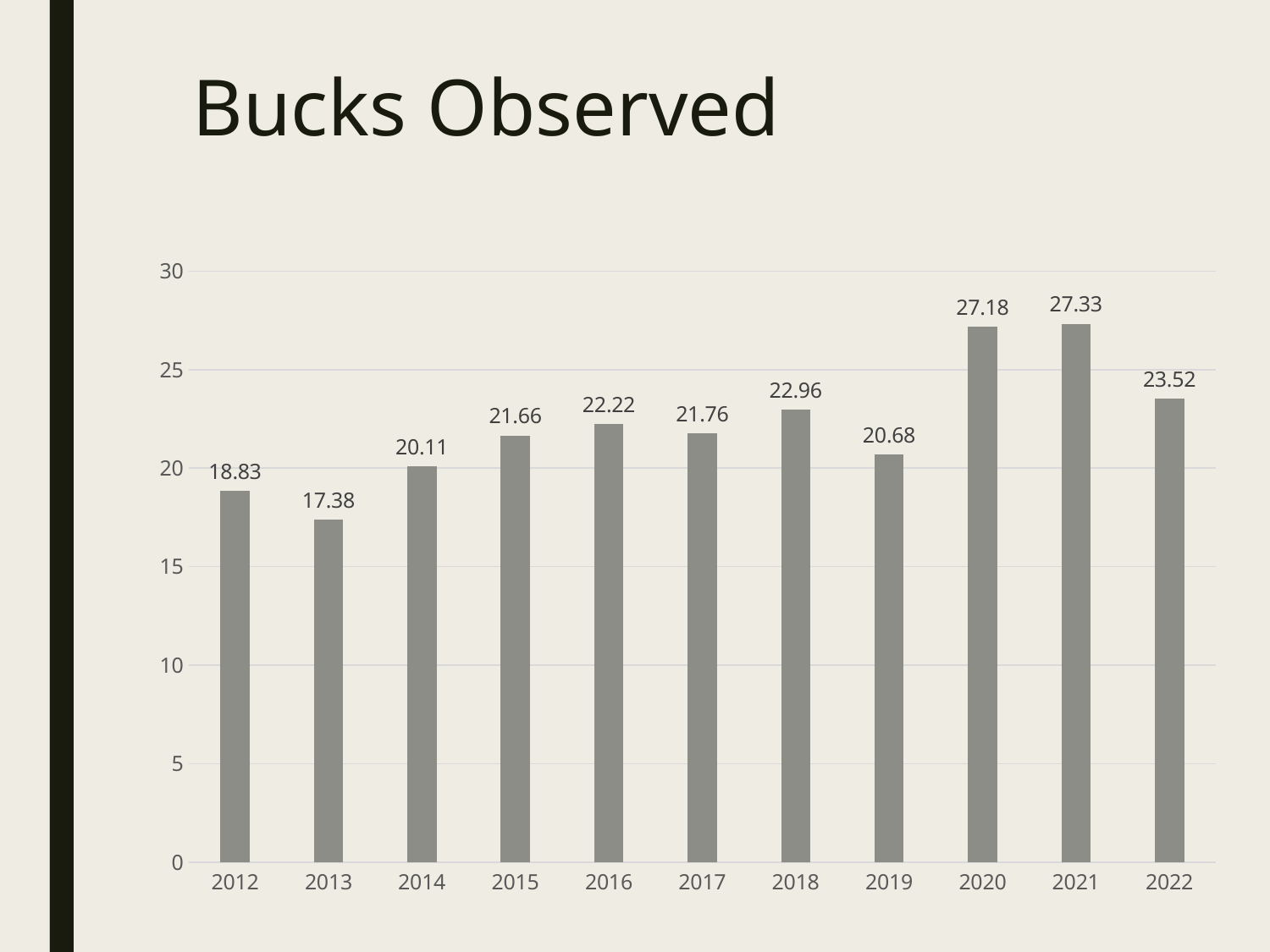
What kind of chart is this? bar chart Is the value for 2013 greater or less than 20? less What is the difference between the values for 2022 and 2012? 4.69 What is the value for 2012? 18.83 What is the difference between the values for 2021 and 2020? 0.15 What is the title of the chart? Bucks Observed Which year has the lowest value? 2013 Which year has the highest value? 2021 What is the value for 2020? 27.18 What is the value for 2022? 23.52 How many years are shown on the x axis? 11 Which is larger, the value for 2016 or the value for 2019? 2016